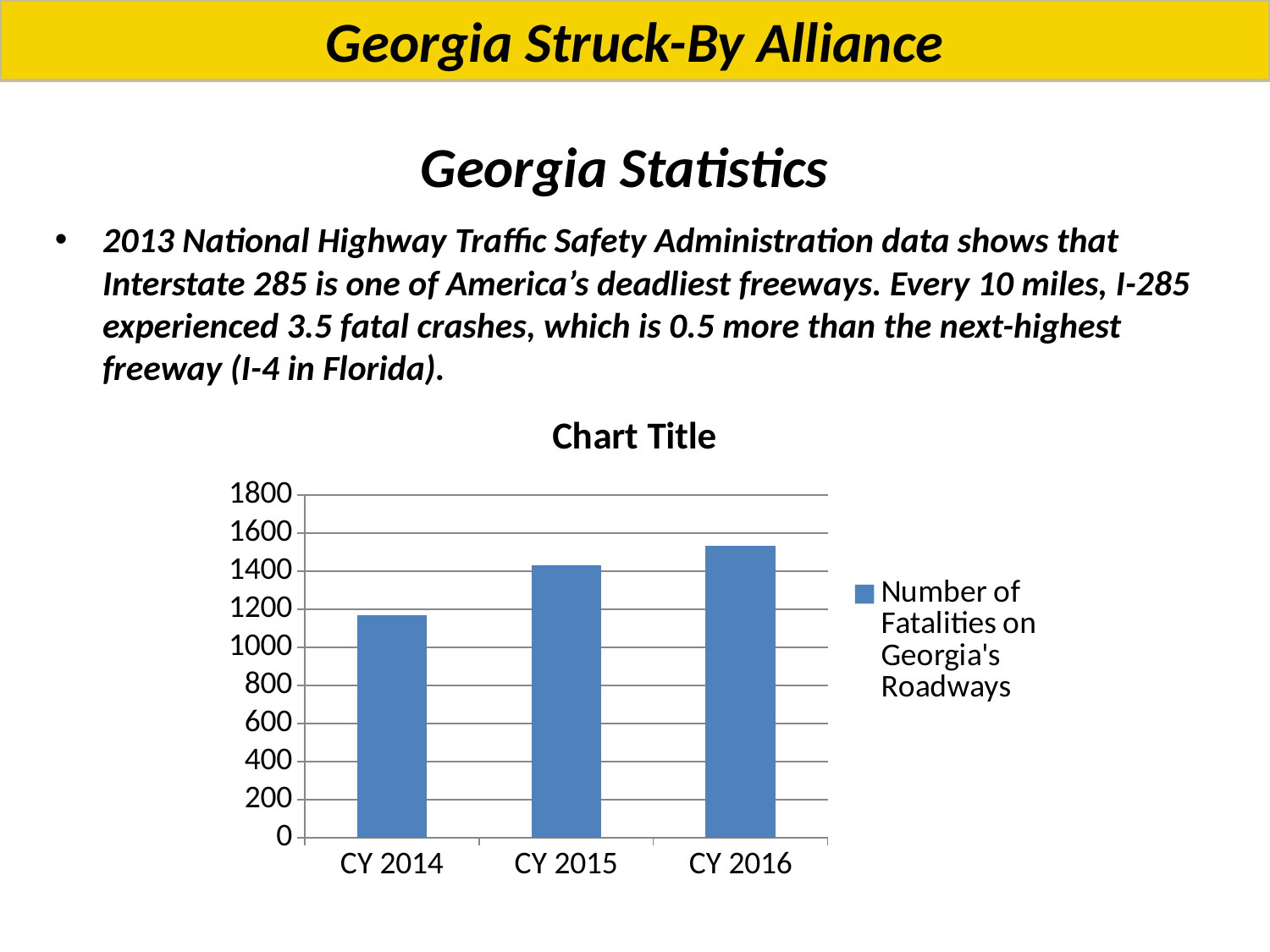
Do the values rise or fall from CY 2014 to CY 2016? rise How many series does the chart's legend list? 1 Is the value for CY 2014 greater or less than 1200? less Which year has the highest number of fatalities on Georgia's roadways? CY 2016 How many categories are shown on the x axis of the chart? 3 Is the value for CY 2014 greater or less than 1000? greater Is the value for CY 2016 greater or less than 1600? less What is the series name shown in the chart's legend? Number of Fatalities on Georgia's Roadways Which is larger, the value for CY 2015 or the value for CY 2014? CY 2015 What kind of chart is shown on the slide? bar chart Which year has the lowest number of fatalities on Georgia's roadways? CY 2014